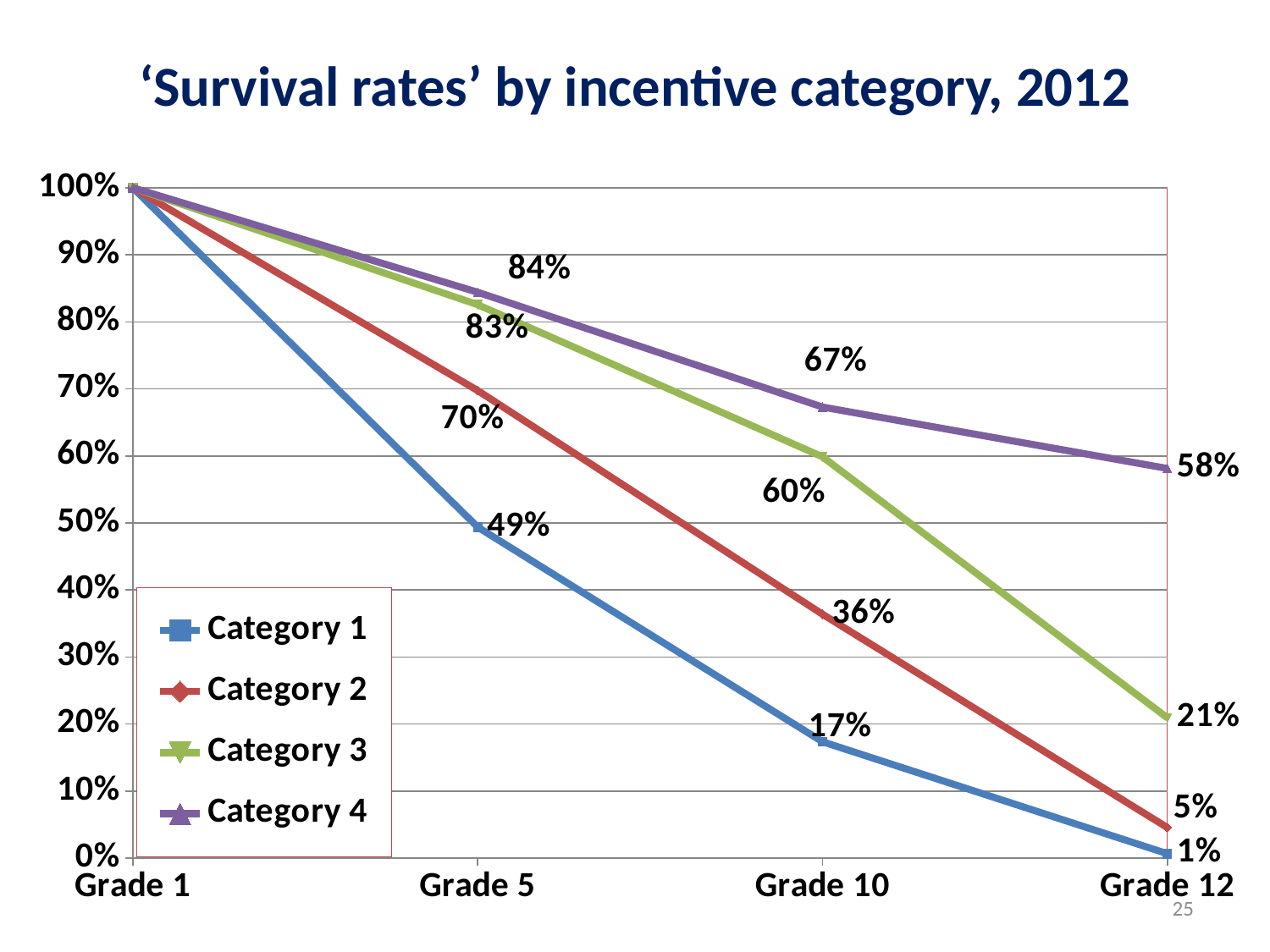
What is the value for Category 1 at Grade 5? 49% What is the value for Category 4 at Grade 10? 67% What is the value for Category 2 at Grade 12? 5% Do the values for Category 1 rise or fall from Grade 1 to Grade 12? Fall What is the value for Category 3 at Grade 10? 60% What kind of chart is shown on the slide? Line chart How many grade points are shown on the x axis? 4 Which category has the highest value at Grade 12? Category 4 What is the difference between Category 4 and Category 3 at Grade 12? 37% How many series does the legend list? 4 Which is larger at Grade 10: Category 2 or Category 3? Category 3 Which category has the lowest value at Grade 10? Category 1